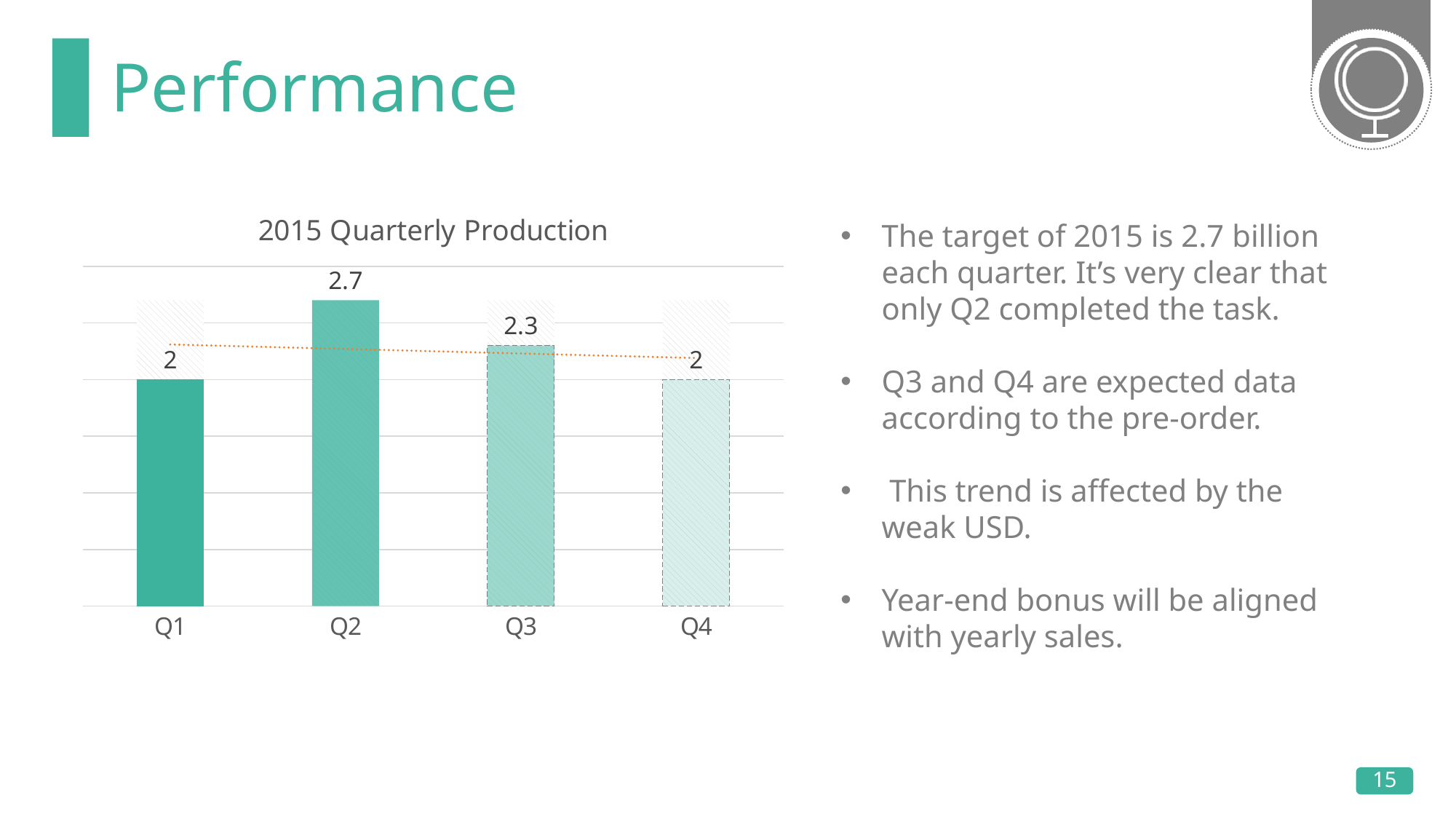
Which quarters share the lowest value in the 2015 Quarterly Production chart? Q1 and Q4 What is the value for Q4 in the 2015 Quarterly Production chart? 2 What is the value for Q3 in the 2015 Quarterly Production chart? 2.3 What is the difference between the Q3 and Q4 values in the 2015 Quarterly Production chart? 0.3 What is the difference between the Q2 and Q1 values in the 2015 Quarterly Production chart? 0.7 What is the value for Q1 in the 2015 Quarterly Production chart? 2 What kind of chart is used to show 2015 Quarterly Production? Bar chart Do the values rise or fall from Q2 to Q4 in the 2015 Quarterly Production chart? Fall Which is larger in the 2015 Quarterly Production chart, the value for Q3 or the value for Q4? Q3 What is the value for Q2 in the 2015 Quarterly Production chart? 2.7 How many quarters are shown in the 2015 Quarterly Production chart? 4 Which quarter has the highest value in the 2015 Quarterly Production chart? Q2